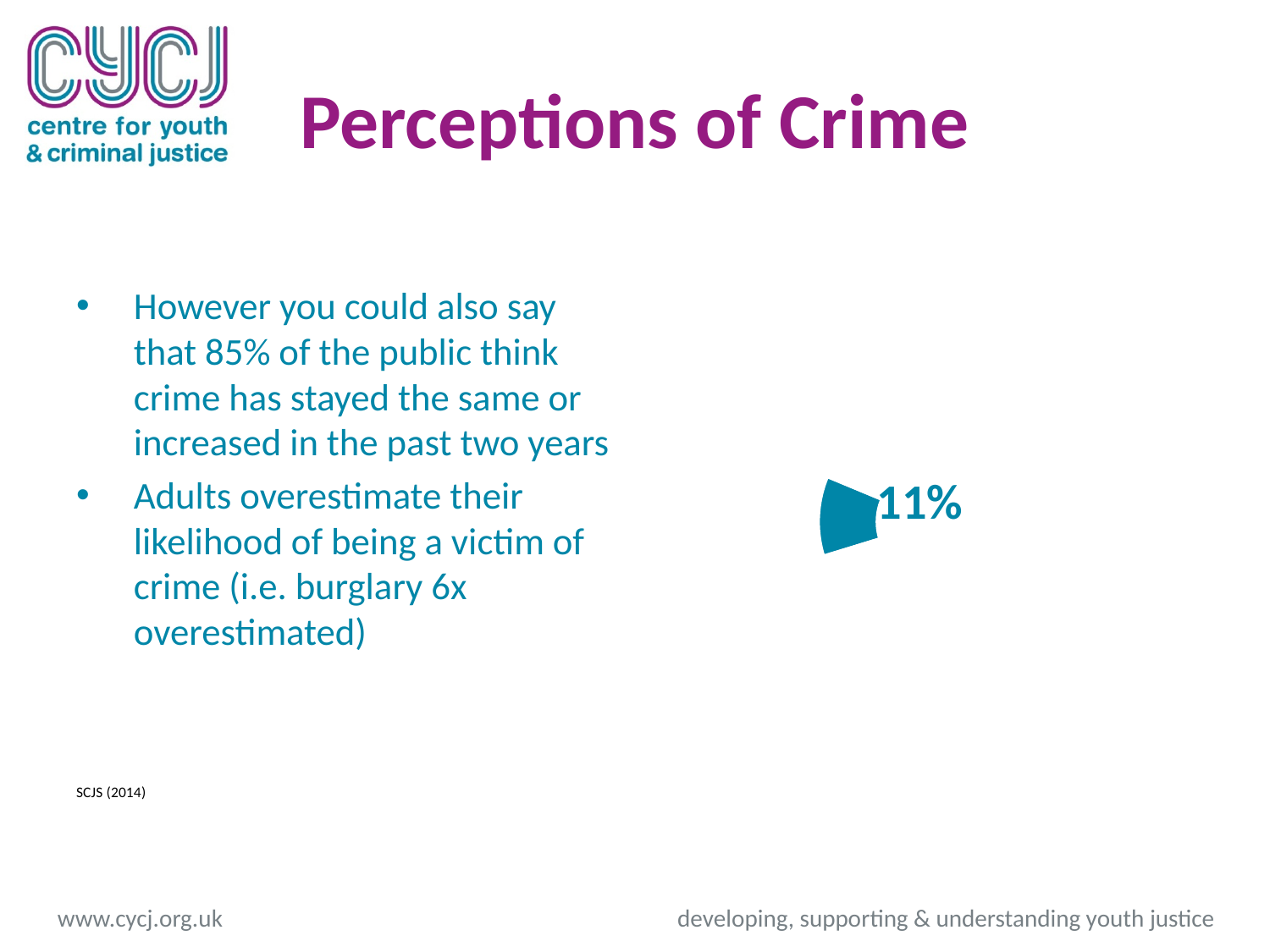
What kind of chart is shown on the right of the slide? pie chart What value is printed on the visible slice of the pie chart? 11% What share of the pie does the labelled slice represent? 11% Is the labelled slice of the pie chart greater or less than 50% of the whole? less How many data labels are printed on the pie chart? 1